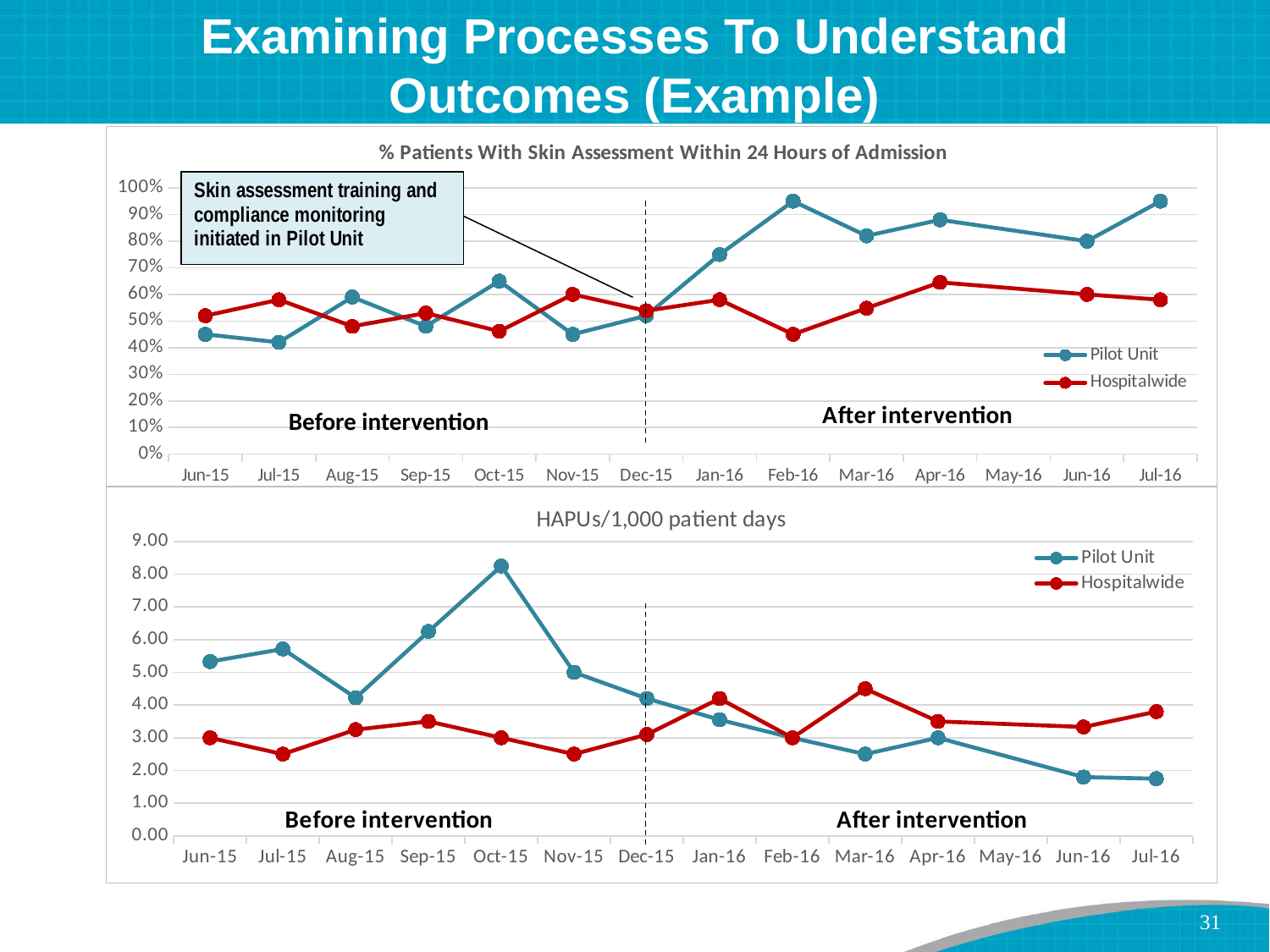
In the top chart, what does the text box in the upper left say was initiated in the Pilot Unit? Skin assessment training and compliance monitoring In the top chart, '% Patients With Skin Assessment Within 24 Hours of Admission', in which month is the Pilot Unit value lowest? Jul-15 In the bottom chart, 'HAPUs/1,000 patient days', in which month is the Pilot Unit value highest? Oct-15 In the top chart, '% Patients With Skin Assessment Within 24 Hours of Admission', is the Pilot Unit value for Feb-16 greater or less than 90%? greater What kind of chart is the top chart, '% Patients With Skin Assessment Within 24 Hours of Admission'? Line chart In the top chart, '% Patients With Skin Assessment Within 24 Hours of Admission', in which month is the Hospitalwide value highest? Apr-16 In the bottom chart, 'HAPUs/1,000 patient days', does the Pilot Unit line generally rise or fall from Dec-15 to Jul-16? Fall In the top chart, '% Patients With Skin Assessment Within 24 Hours of Admission', is the Pilot Unit value for Jul-15 greater or less than 50%? less In the top chart, '% Patients With Skin Assessment Within 24 Hours of Admission', how many months are labelled on the x axis? 14 How many series does the legend of the bottom chart, 'HAPUs/1,000 patient days', list? 2 In the bottom chart, 'HAPUs/1,000 patient days', is the Pilot Unit value for Oct-15 greater or less than 8.00? greater In the bottom chart, 'HAPUs/1,000 patient days', which series has the larger value in Oct-15, Pilot Unit or Hospitalwide? Pilot Unit